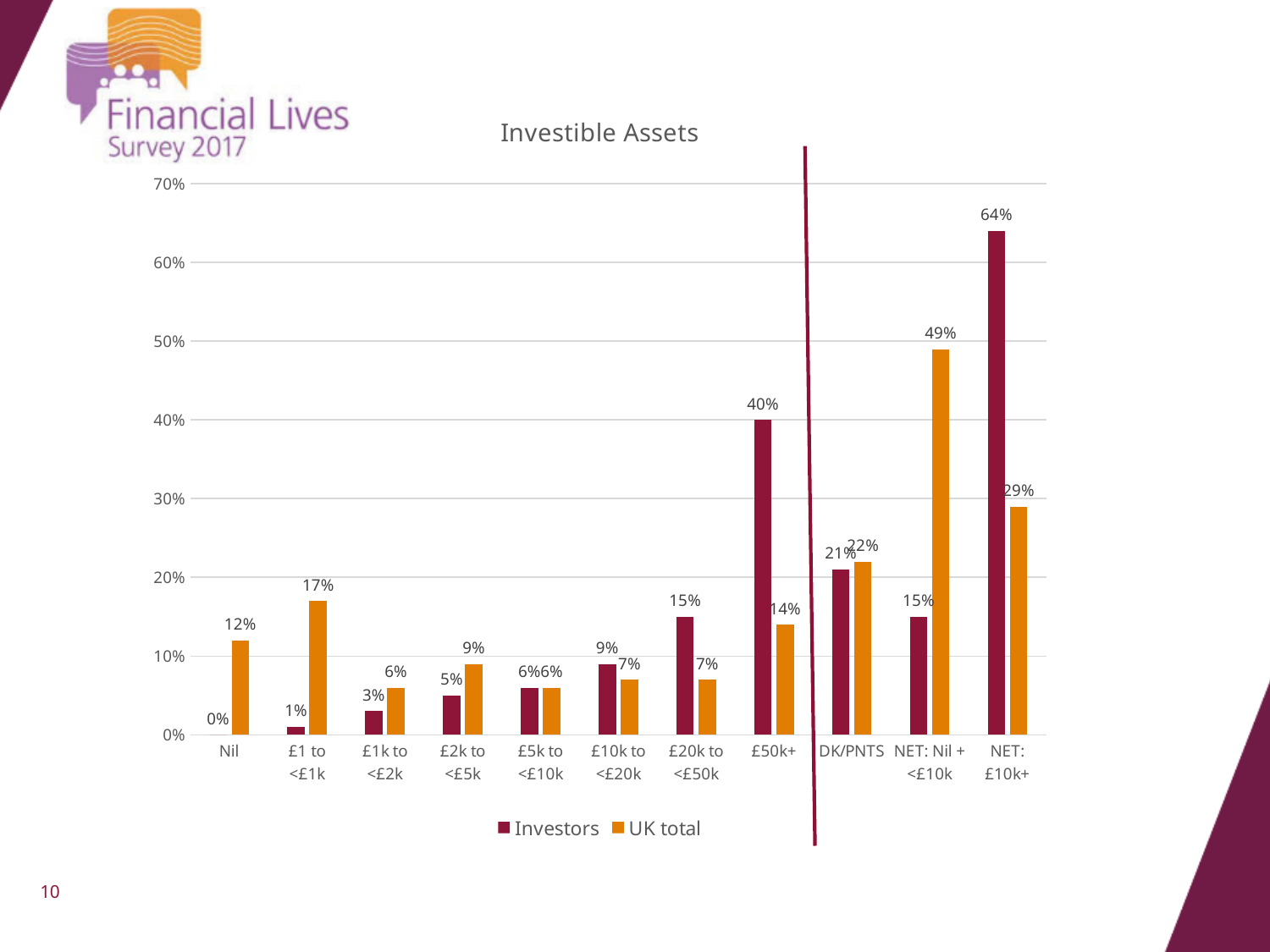
What is the value for Investors in the £50k+ category? 40% What is the title of the chart? Investible Assets What is the value for UK total in the Nil category? 12% How many categories are shown on the x axis? 11 How many series does the legend list? 2 What is the value for UK total in the NET: Nil + <£10k category? 49% Which category has the highest value for Investors? NET: £10k+ In the £20k to <£50k category, which series has the larger value, Investors or UK total? Investors What is the difference between the Investors and UK total values in the NET: £10k+ category? 35% What kind of chart is shown on the slide? Bar chart Which category has the lowest value for Investors? Nil In the £1 to <£1k category, which series has the larger value, Investors or UK total? UK total